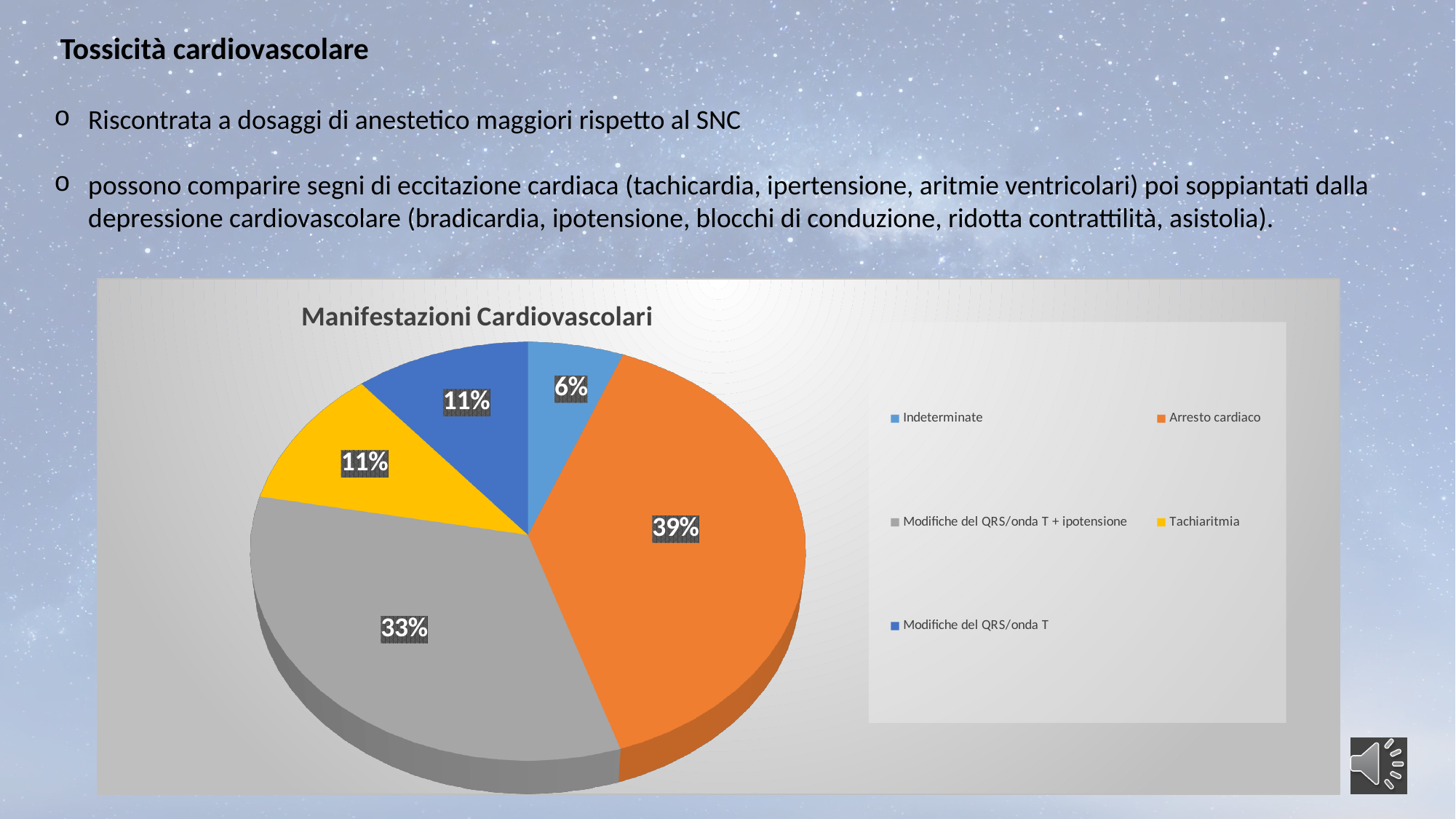
What is the title of the chart? Manifestazioni Cardiovascolari How many categories does the legend list? 5 What kind of chart is shown on the slide? Pie chart What share of the pie does Arresto cardiaco represent? 39% What is the difference in percentage points between Arresto cardiaco and Modifiche del QRS/onda T + ipotensione? 6 Which is larger, the share for Tachiaritmia or the share for Indeterminate? Tachiaritmia What share of the pie does Indeterminate represent? 6% What share of the pie does Modifiche del QRS/onda T + ipotensione represent? 33% What colour is the Arresto cardiaco slice? Orange Which category has the smallest slice of the pie? Indeterminate Which category has the largest slice of the pie? Arresto cardiaco